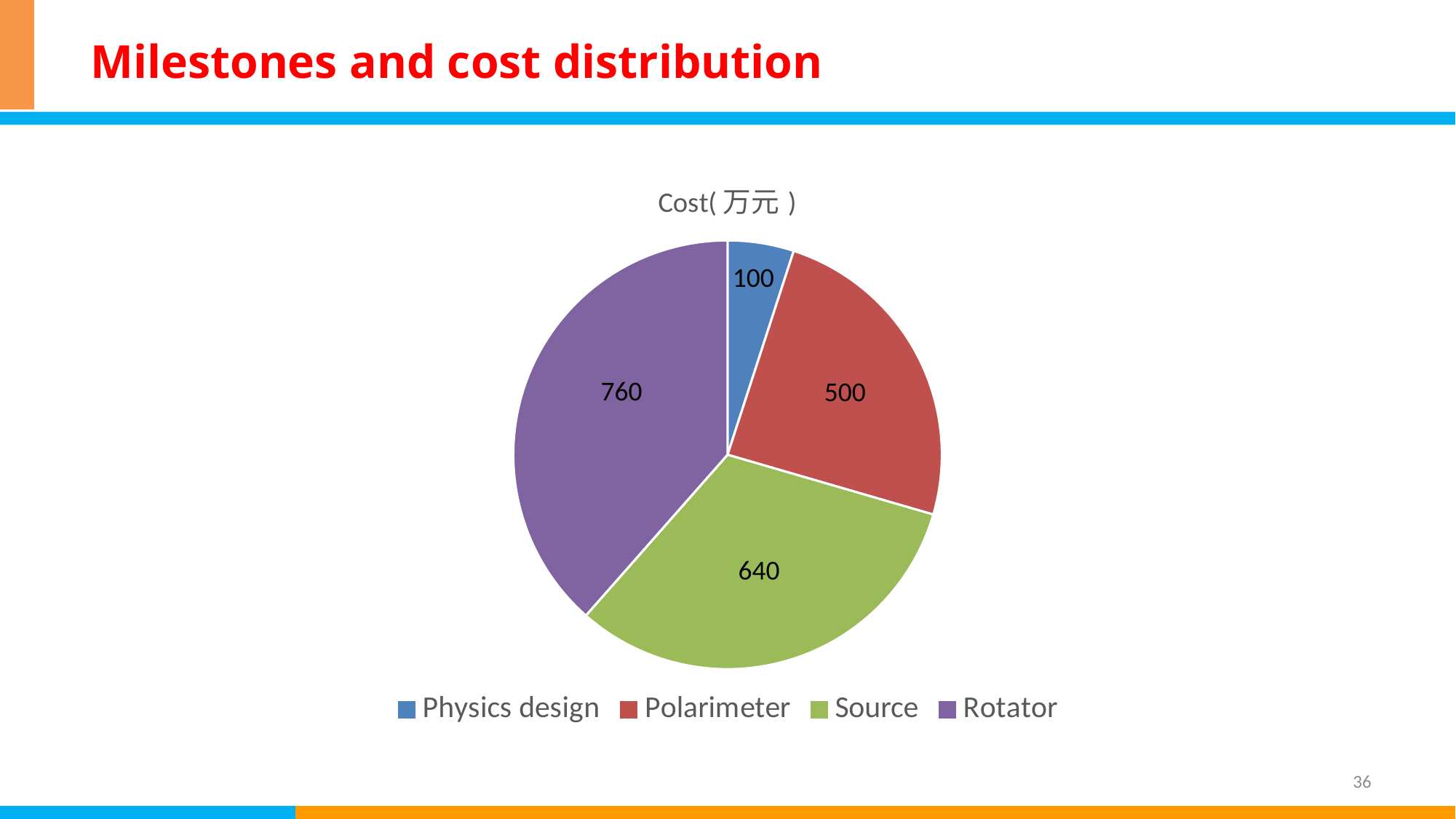
What is the cost for Rotator? 760 What kind of chart is shown on the slide? Pie chart What is the title of the chart? Cost(万元) What is the difference between the cost for Rotator and the cost for Source? 120 What share of the total cost does Polarimeter represent? 25% Which has a larger cost, Source or Polarimeter? Source Which category has the largest cost? Rotator What is the cost for Polarimeter? 500 What is the total cost across all four categories? 2000 Which category has the smallest cost? Physics design How many categories are shown in the pie chart? 4 What is the cost for Physics design? 100